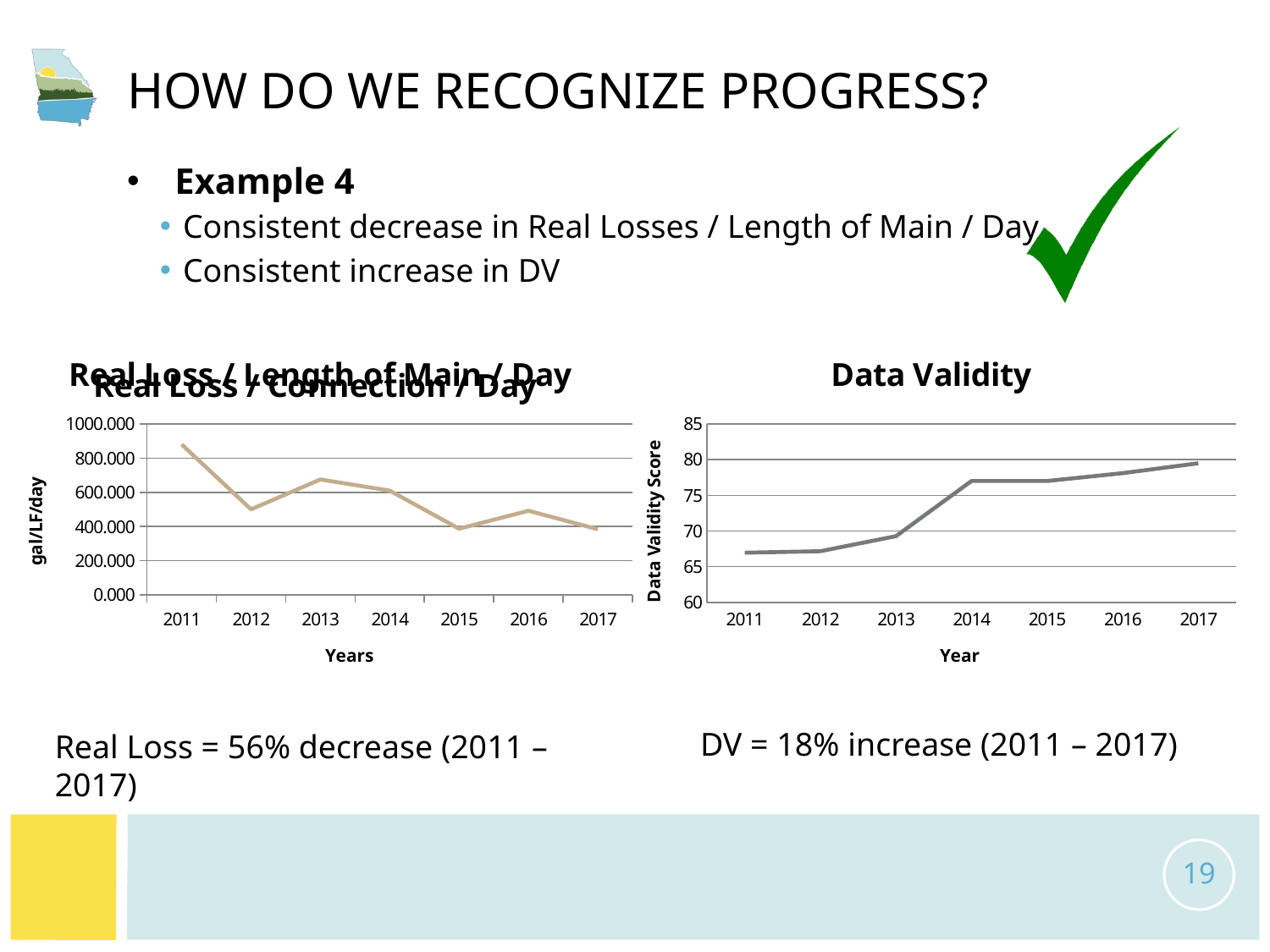
In the Data Validity chart, which year has the highest score? 2017 In the Data Validity chart, do the values generally rise or fall from 2011 to 2017? rise In the Data Validity chart, is the score for 2014 greater or less than 75? greater In the left chart (Real Loss), is the value for 2011 greater or less than 800.000? greater In the left chart (Real Loss), which year has the larger value, 2011 or 2012? 2011 In the left chart (Real Loss), which year has the highest value? 2011 In the Data Validity chart, is the score for 2011 greater or less than 70? less How many years are plotted on the x axis of the Data Validity chart? 7 What kind of chart is the Data Validity chart on the right? line chart What is the y-axis title of the Data Validity chart? Data Validity Score In the Data Validity chart, which year has the larger score, 2013 or 2014? 2014